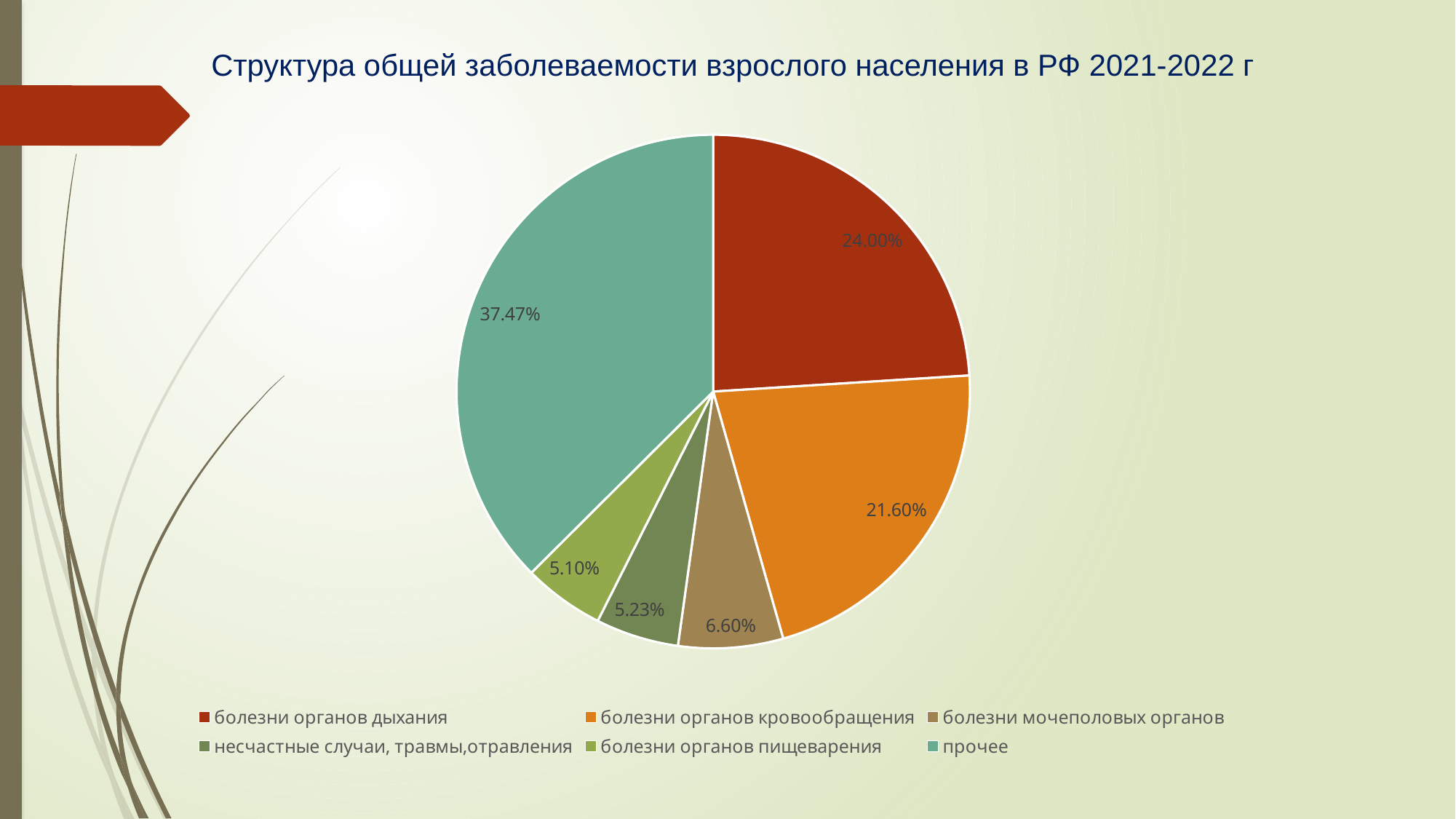
What share of the pie does "болезни органов пищеварения" have? 5.10% What share of the pie does "прочее" have? 37.47% How many categories does the pie chart have? 6 What is the difference in percentage points between the "прочее" slice and the "болезни органов дыхания" slice? 13.47 What share of the pie does "болезни мочеполовых органов" have? 6.60% Which is larger: the slice for "болезни органов дыхания" or the slice for "болезни органов кровообращения"? болезни органов дыхания What kind of chart is shown on the slide? pie chart Which category has the largest slice of the pie? прочее What share of the pie does "болезни органов кровообращения" have? 21.60% Which category has the smallest slice of the pie? болезни органов пищеварения What share of the pie does "болезни органов дыхания" have? 24.00% What is the title of the chart? Структура общей заболеваемости взрослого населения в РФ 2021-2022 г